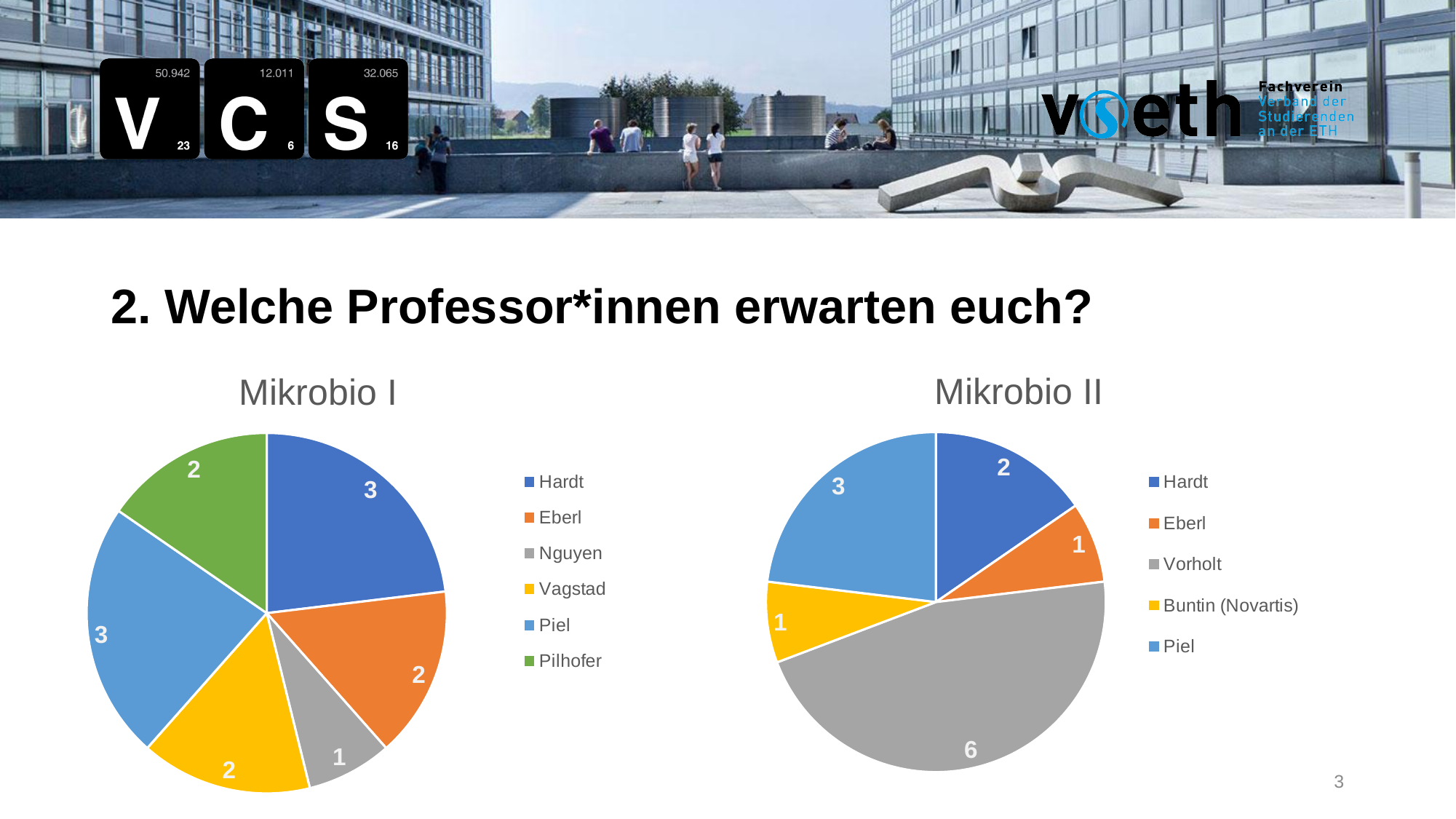
In the Mikrobio II chart, what is the difference between the values for Vorholt and Piel? 3 In the Mikrobio I chart, which category has the smallest slice? Nguyen In the Mikrobio I chart, which is larger, the value for Piel or the value for Eberl? Piel What is the total of all slices in the Mikrobio II chart? 13 In the Mikrobio I chart, what is the value for Nguyen? 1 In the Mikrobio II chart, what is the value for Buntin (Novartis)? 1 In the Mikrobio II chart, which category has the largest slice? Vorholt How many categories does the Mikrobio I chart show? 6 In the Mikrobio I chart, what is the value for Hardt? 3 How many categories does the Mikrobio II chart show? 5 In the Mikrobio II chart, what is the value for Vorholt? 6 What kind of chart is the Mikrobio II chart? Pie chart